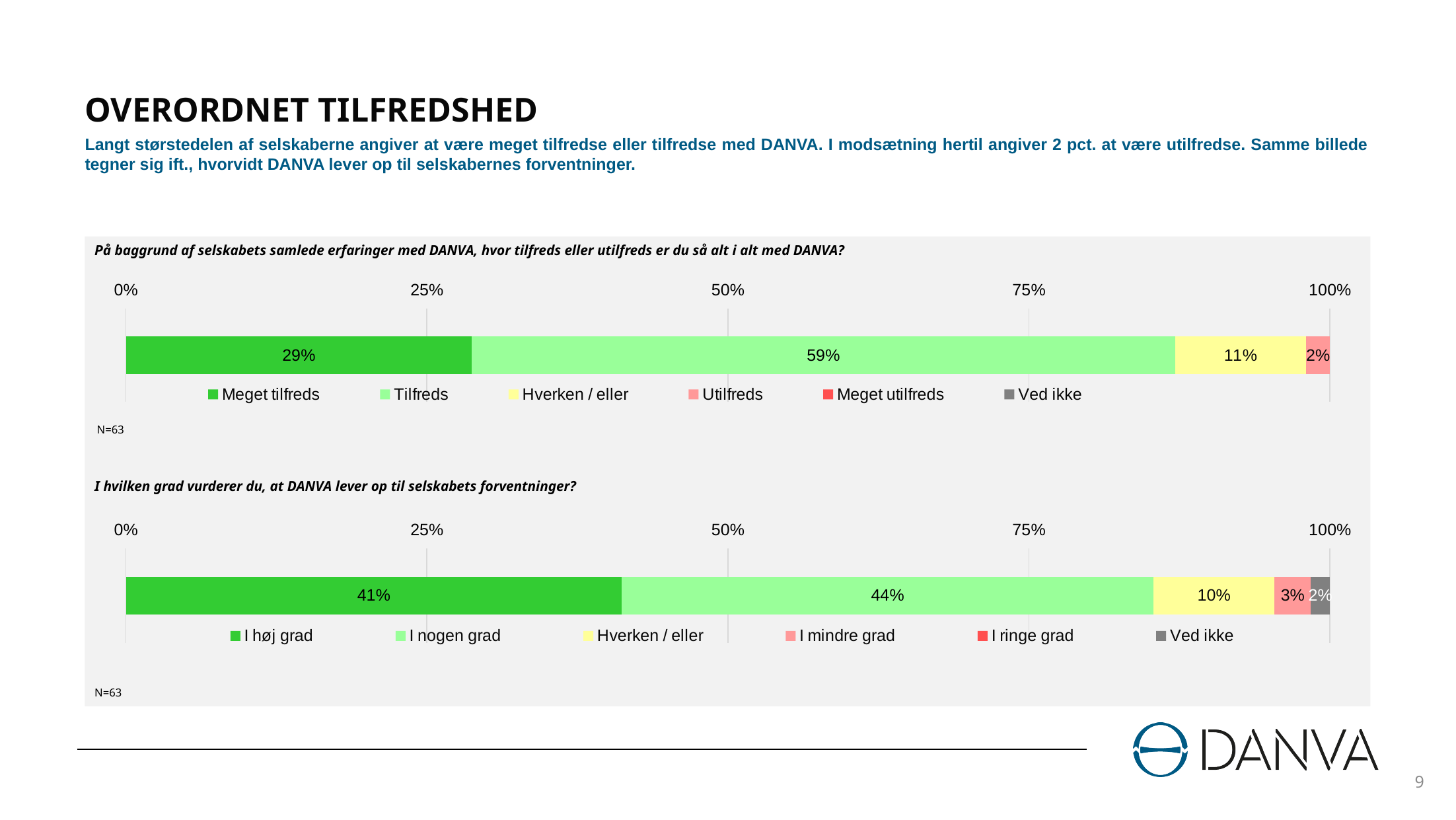
In the top chart, which response category has the largest share? Tilfreds What type of chart is used in the top chart? Stacked bar chart In the bottom chart (whether DANVA meets expectations), what share answered 'I høj grad'? 41% In the bottom chart, what share answered 'I nogen grad'? 44% In the bottom chart, which is larger: 'I høj grad' or 'I nogen grad'? I nogen grad In the top chart, what share of respondents answered 'Utilfreds'? 2% How many series does the legend of the bottom chart list? 6 In the top chart (overall satisfaction with DANVA), what share of respondents answered 'Meget tilfreds'? 29% In the top chart, what share of respondents answered 'Hverken / eller'? 11% In the top chart, what share of respondents answered 'Tilfreds'? 59% In the top chart, what is the difference between the 'Tilfreds' and 'Meget tilfreds' shares? 30% In the bottom chart, what share answered 'I mindre grad'? 3%